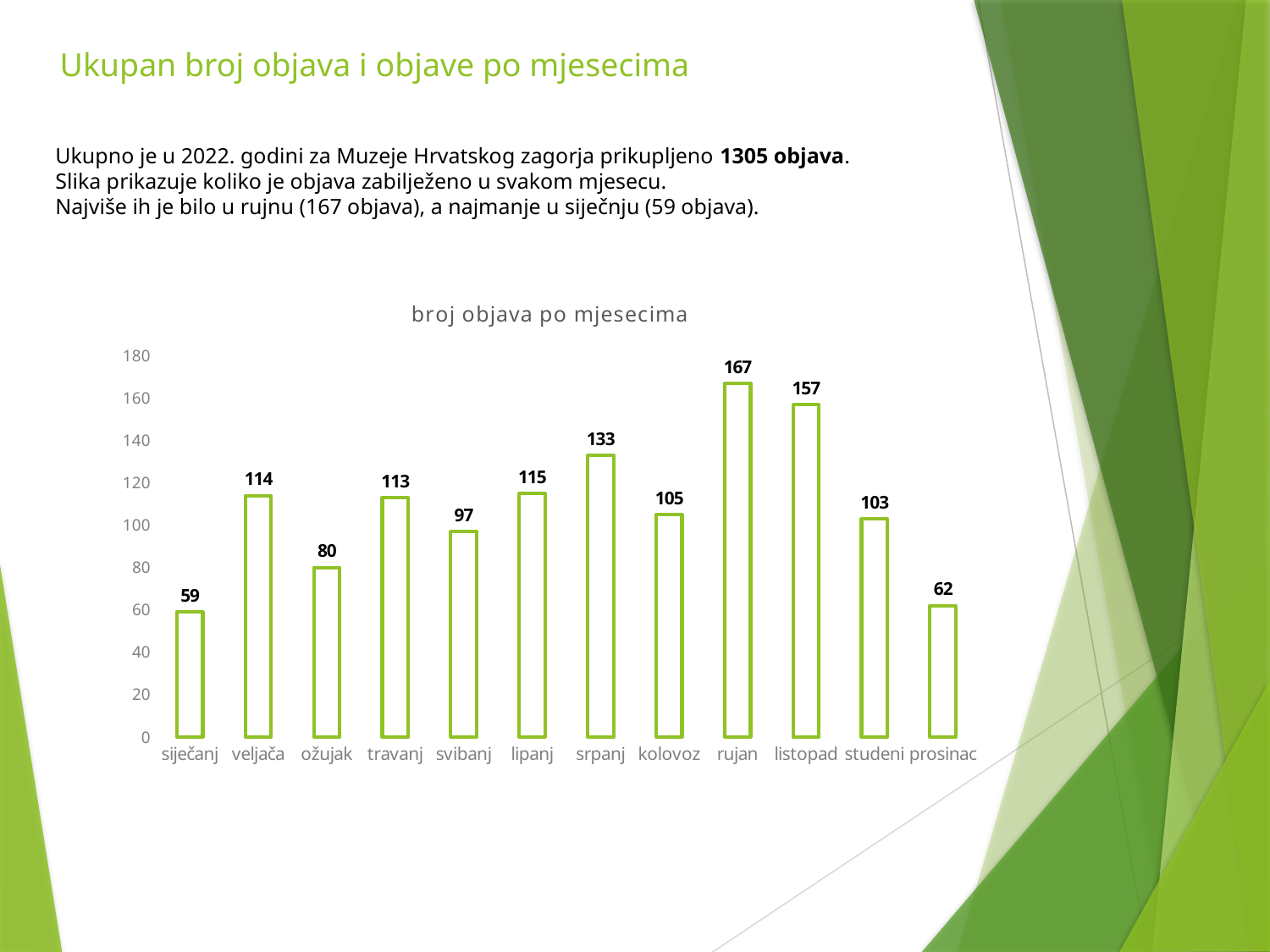
What is the value for rujan? 167 Which is larger, the value for veljača or the value for travanj? veljača Which month has the lowest value? siječanj What is the value for ožujak? 80 How many months are shown on the x axis? 12 What is the difference between the values for srpanj and kolovoz? 28 Which month has the highest value? rujan Is the value for svibanj greater or less than 100? less What kind of chart is shown on the slide? bar chart What is the value for listopad? 157 What is the title of the chart? broj objava po mjesecima What is the difference between the values for rujan and siječanj? 108